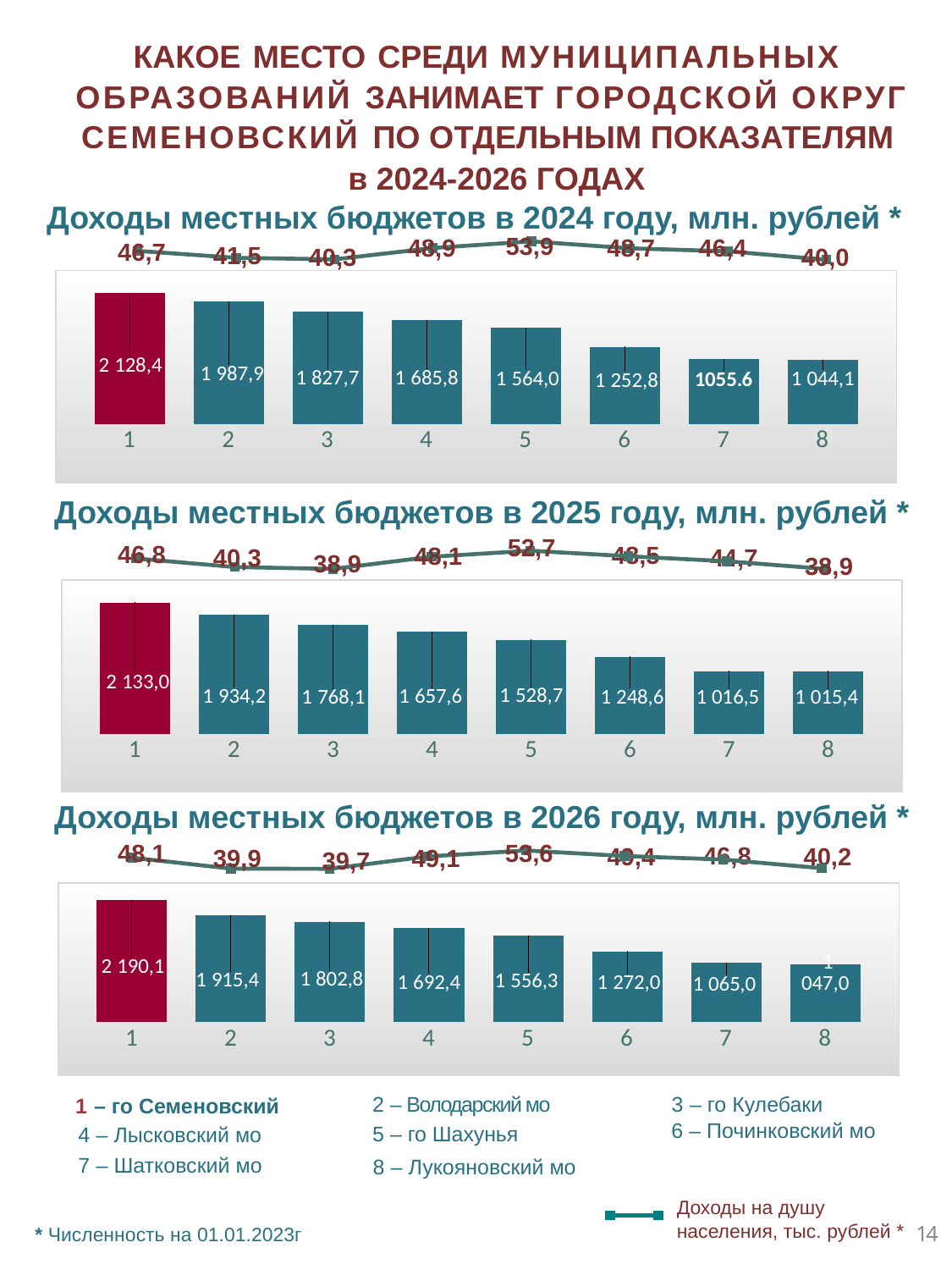
In the chart 'Доходы местных бюджетов в 2026 году, млн. рублей', do the bar values rise or fall from category 1 to category 8? fall In the chart 'Доходы местных бюджетов в 2026 году, млн. рублей', which is larger: the bar for category 4 or the bar for category 5? category 4 In the chart 'Доходы местных бюджетов в 2026 году, млн. рублей', what is the value of the bar for category 3? 1 802,8 In the chart 'Доходы местных бюджетов в 2024 году, млн. рублей', what is the value of the bar for category 1? 2 128,4 In the chart 'Доходы местных бюджетов в 2025 году, млн. рублей', which category has the highest bar? 1 In the chart 'Доходы местных бюджетов в 2024 году, млн. рублей', what is the per-capita income (line value) for category 5? 53,9 In the chart 'Доходы местных бюджетов в 2024 году, млн. рублей', what is the difference between the bars for category 1 and category 2? 140,5 What type of chart is 'Доходы местных бюджетов в 2024 году, млн. рублей'? bar chart with a line In the chart 'Доходы местных бюджетов в 2025 году, млн. рублей', what is the value of the bar for category 5? 1 528,7 According to the legend at the bottom of the slide, which municipality does category 1 represent? го Семеновский In the chart 'Доходы местных бюджетов в 2026 году, млн. рублей', which category has the lowest bar? 8 How many categories are shown in the chart 'Доходы местных бюджетов в 2025 году, млн. рублей'? 8